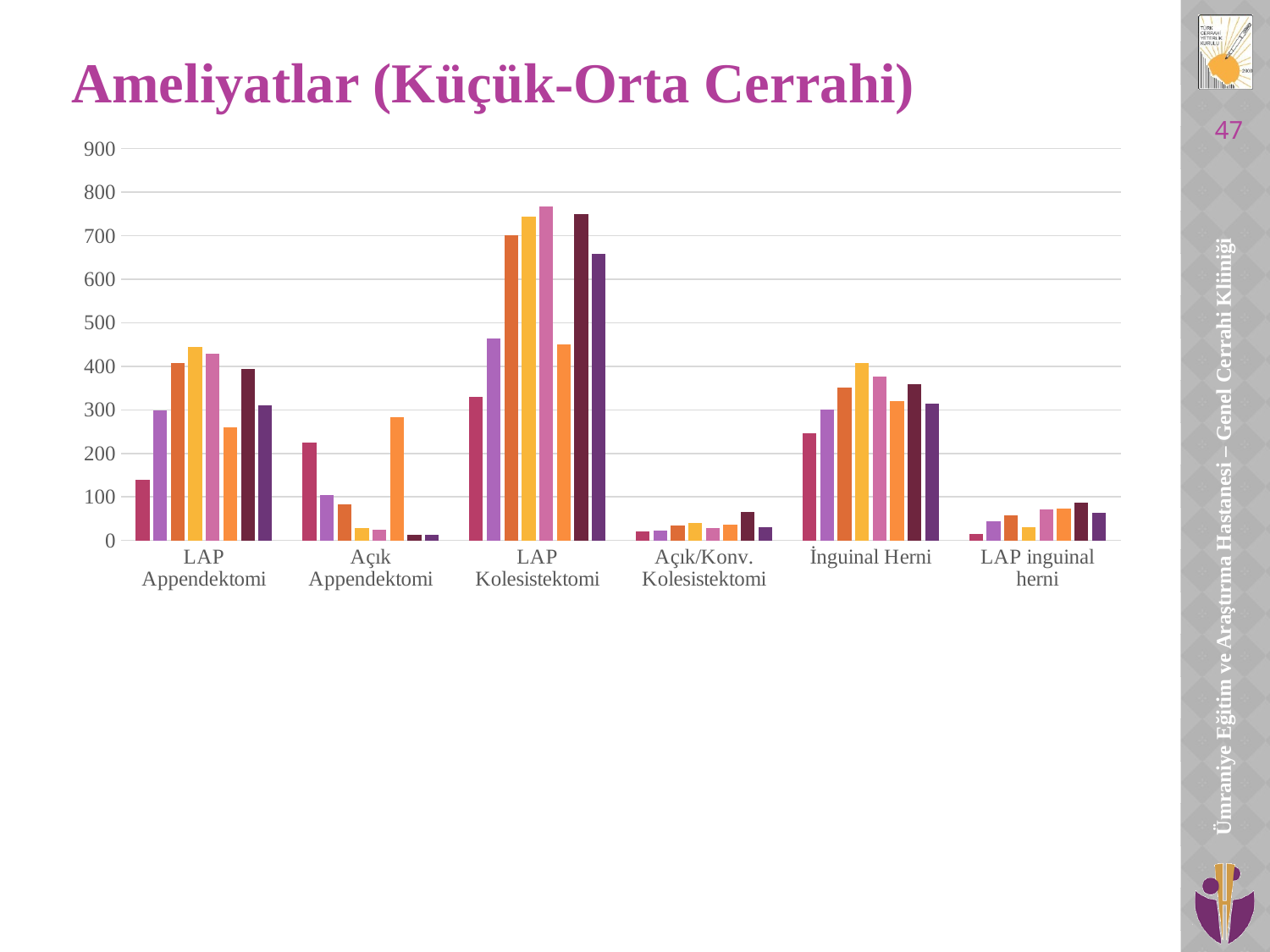
How many categories are shown on the x axis of the chart? 6 Is the tallest bar in the LAP inguinal herni group greater or less than 100? less Which category contains the tallest bar in the chart? LAP Kolesistektomi What type of chart is shown on the slide? bar chart What is the title of the slide containing the chart? Ameliyatlar (Küçük-Orta Cerrahi) Is the tallest bar in the LAP Kolesistektomi group greater or less than 700? greater Which group has a taller maximum bar: LAP Appendektomi or Açık Appendektomi? LAP Appendektomi Is the tallest bar in the LAP Appendektomi group greater or less than 400? greater What is the highest value shown on the vertical axis of the chart? 900 How many bars are plotted for each category in the chart? 8